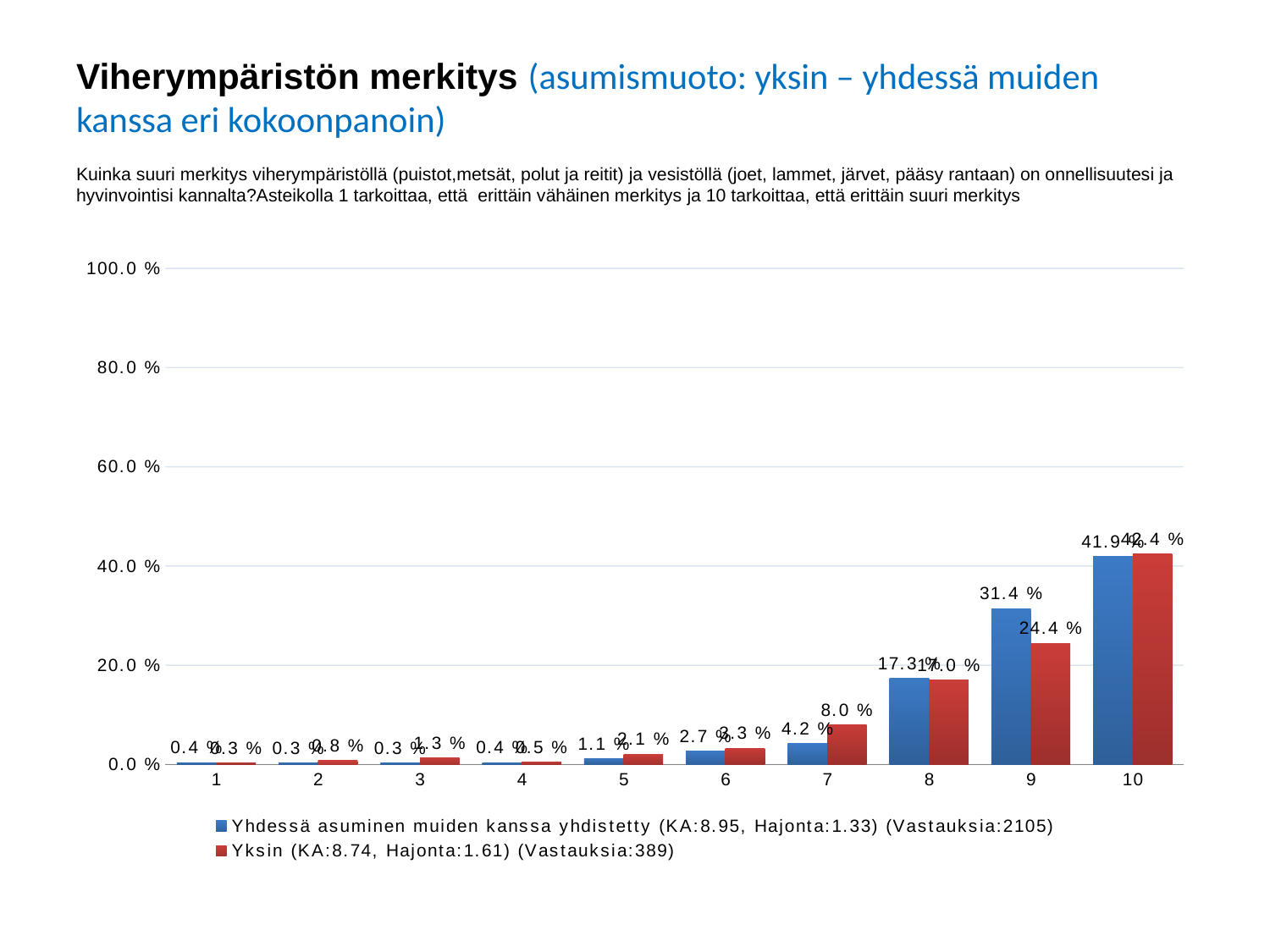
How many categories are shown on the x axis? 10 Which category has the highest value in the 'Yhdessä asuminen muiden kanssa yhdistetty' series? 10 What kind of chart is shown on the slide? bar chart What is the value for category 9 in the 'Yhdessä asuminen muiden kanssa yhdistetty' series? 31.4 % What is the value for category 9 in the 'Yksin' series? 24.4 % What is the value for category 7 in the 'Yhdessä asuminen muiden kanssa yhdistetty' series? 4.2 % How many series does the legend list? 2 What is the value for category 7 in the 'Yksin' series? 8.0 % Is the value for category 10 in the 'Yhdessä asuminen muiden kanssa yhdistetty' series greater or less than 40.0 %? greater What is the difference between the 'Yhdessä asuminen muiden kanssa yhdistetty' and 'Yksin' values for category 9? 7.0 % Which category has the lowest value in the 'Yksin' series? 1 For category 7, which series has the larger value? Yksin